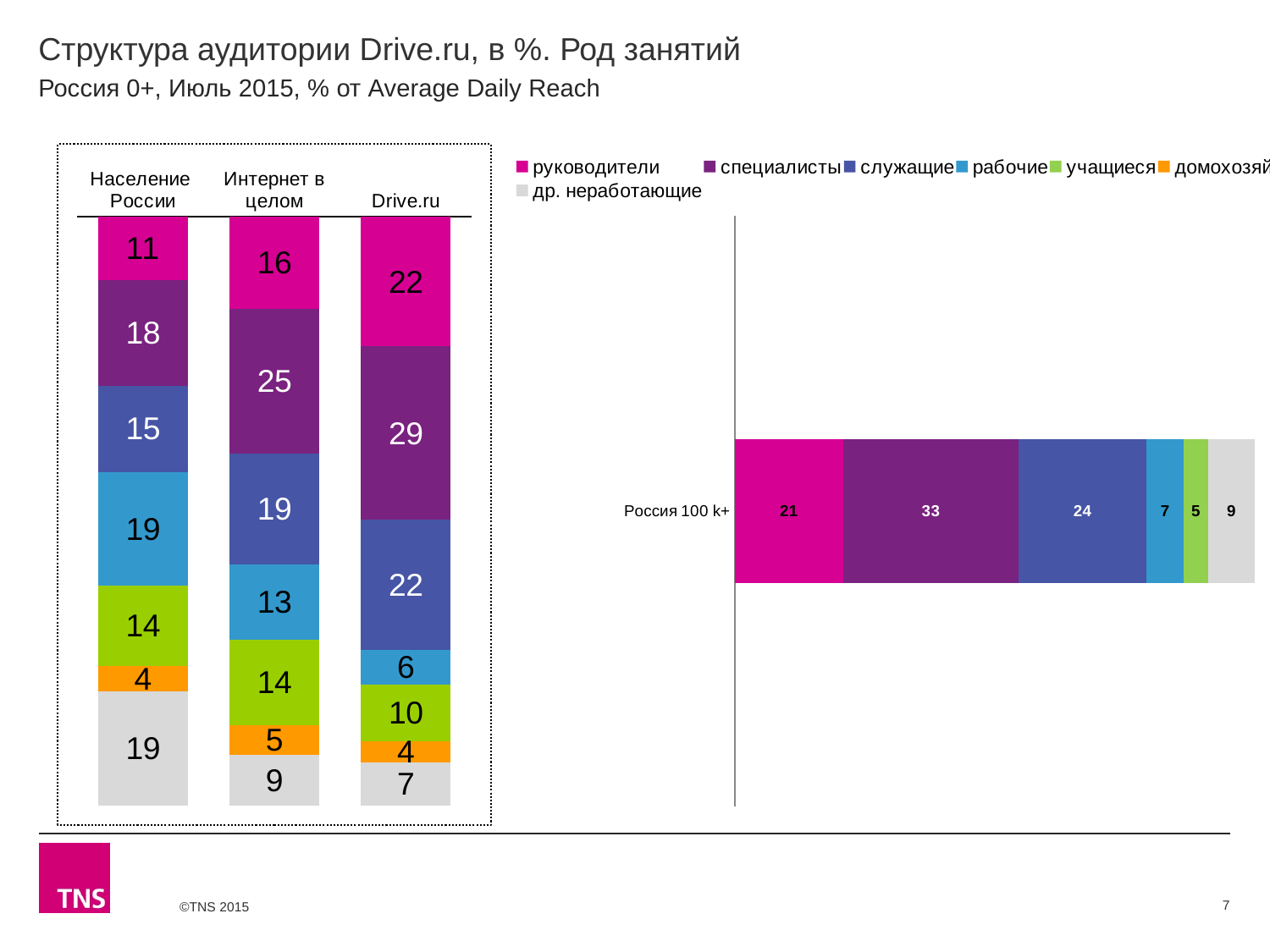
In the left chart, which of the three bars has the lowest value for рабочие? Drive.ru In the left chart, what is the difference between the специалисты values for Drive.ru and Население России? 11 What kind of chart is the right chart (Россия 100 k+)? Stacked bar chart In the left chart, is the учащиеся value larger for Население России or for Drive.ru? Население России In the left chart, what is the value for рабочие in the Интернет в целом bar? 13 In the left chart, what is the value for руководители in the Население России bar? 11 How many bars does the left chart show? 3 How many series does the legend on the slide list? 7 In the right chart (Россия 100 k+), what is the value for специалисты? 33 In the left chart, which of the three bars has the highest value for руководители? Drive.ru In the left chart, what is the value for специалисты in the Drive.ru bar? 29 In the right chart (Россия 100 k+), what is the value for служащие? 24